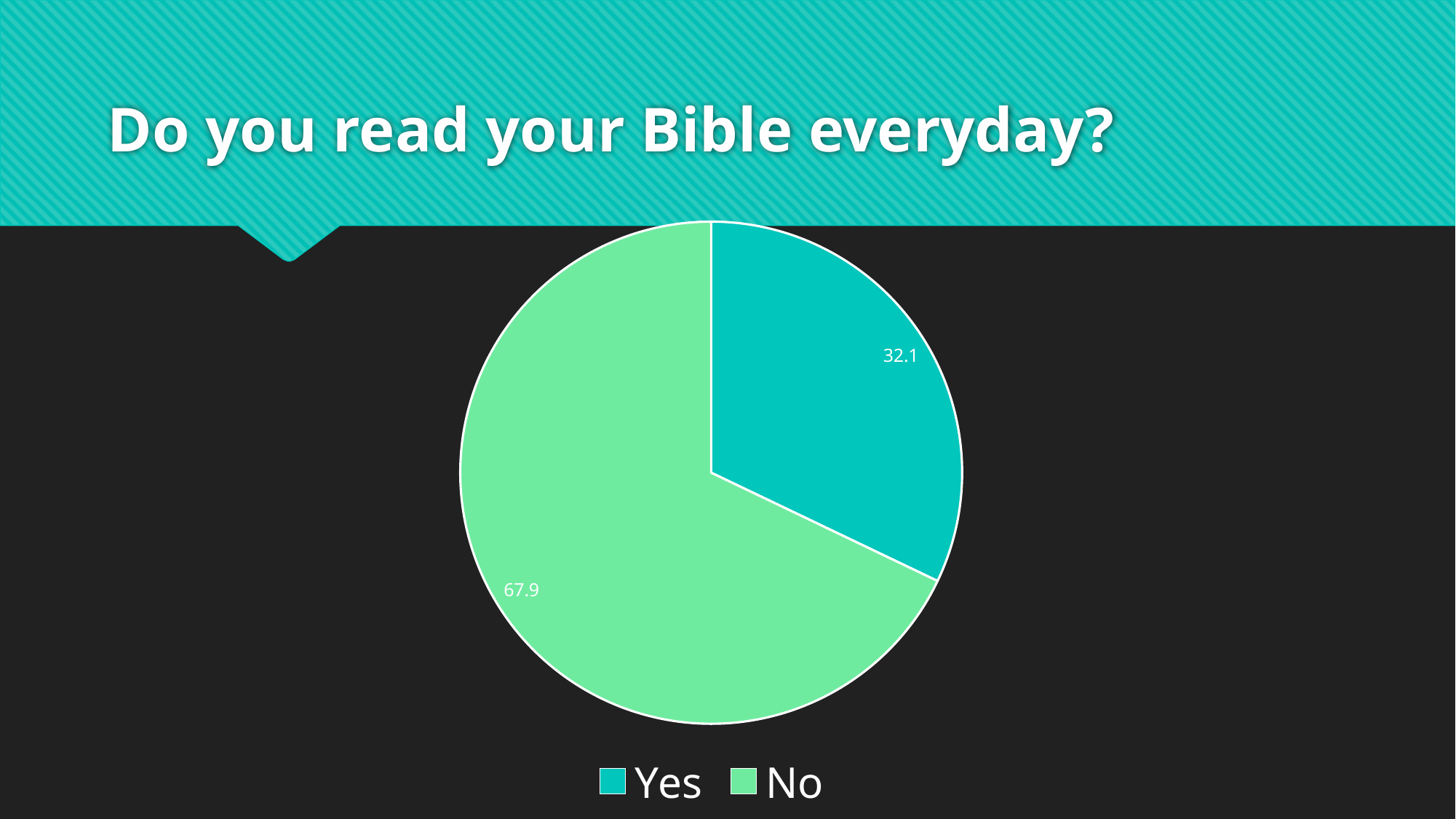
Which legend entry is shown in the lighter green colour? No What is the difference between the No and Yes values? 35.8 What kind of chart is shown on the slide? Pie chart What is the title of the slide? Do you read your Bible everyday? What is the total of the two slice values? 100 How many slices does the pie chart have? 2 What is the value for the No slice? 67.9 Which slice is the largest? No Which slice is the smallest? Yes Which is larger, the Yes slice or the No slice? No What is the value for the Yes slice? 32.1 How many entries does the legend list? 2